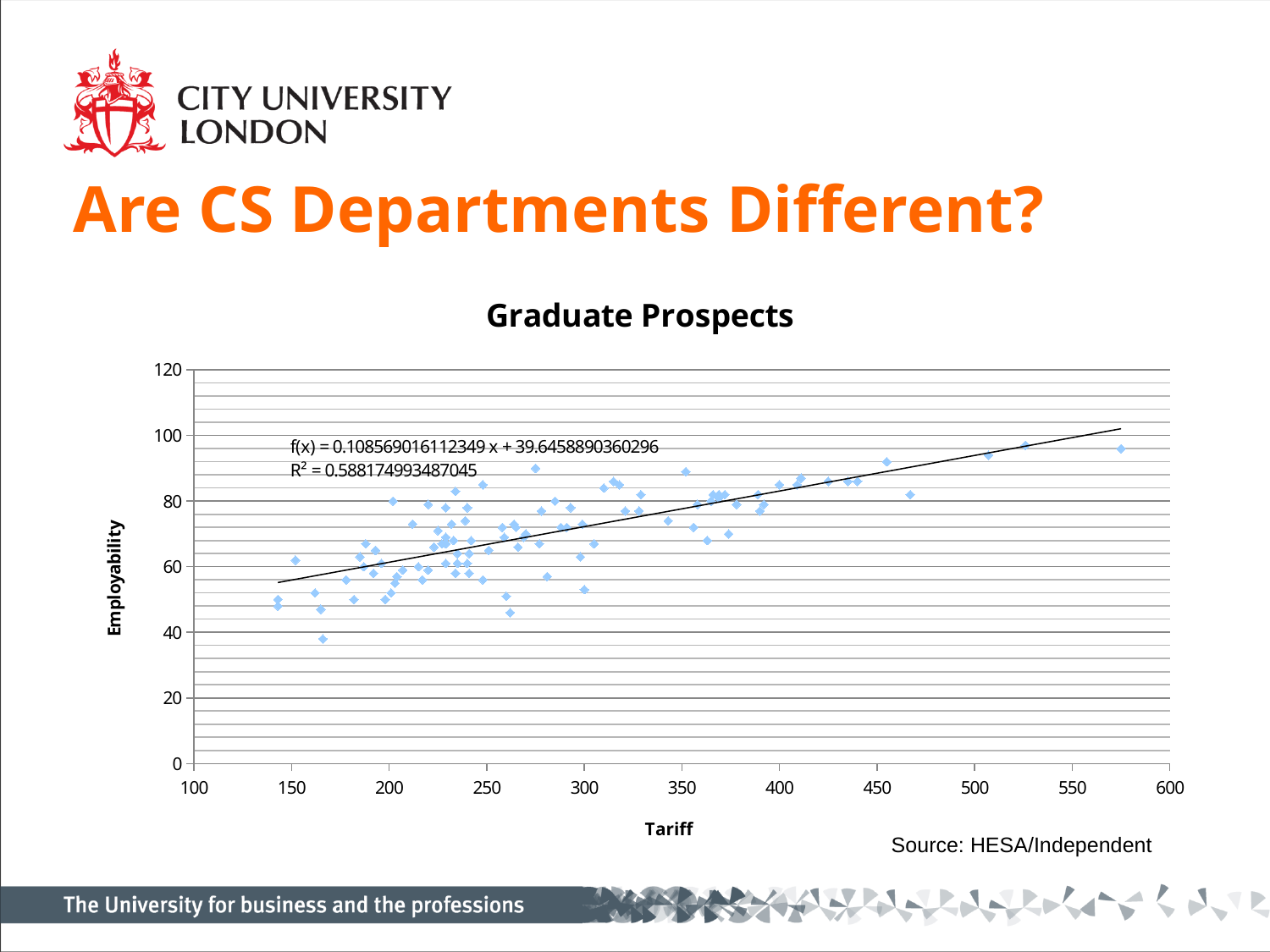
What is the minimum value shown on the Tariff axis? 100 What is the title of the chart? Graduate Prospects Do the plotted values generally rise or fall as Tariff increases along the x axis? Rise What is the slope (coefficient of x) in the trendline equation printed on the chart? 0.108569016112349 What is the intercept in the trendline equation printed on the chart? 39.6458890360296 What is the maximum value shown on the Employability axis? 120 Which has the higher Employability: the point near Tariff 525 or the point near Tariff 165? The point near Tariff 525 What kind of chart is shown on the slide? Scatter chart Is the Employability value for the point with the highest Tariff (around 575) greater or less than 80? greater What is the label of the vertical axis? Employability Is the Employability value for the lowest point on the chart (near Tariff 165) greater or less than 40? less What is the R² value printed on the chart for the trendline? 0.588174993487045